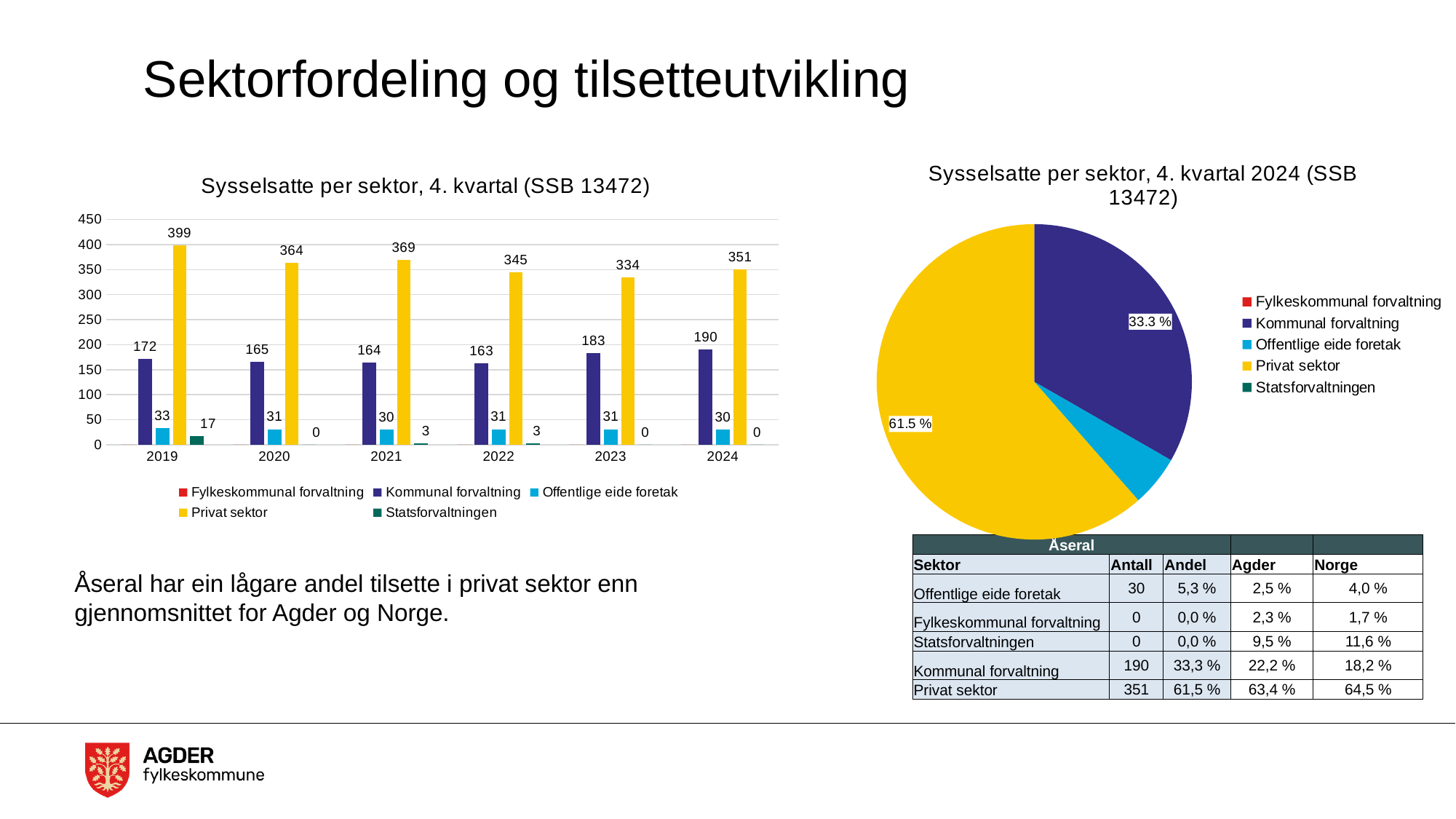
In the bar chart 'Sysselsatte per sektor, 4. kvartal (SSB 13472)', what is the value for Kommunal forvaltning in 2024? 190 In the bar chart 'Sysselsatte per sektor, 4. kvartal (SSB 13472)', how many years are shown on the x axis? 6 In the pie chart 'Sysselsatte per sektor, 4. kvartal 2024 (SSB 13472)', what share does Privat sektor have? 61.5 % In the bar chart 'Sysselsatte per sektor, 4. kvartal (SSB 13472)', what is the value for Privat sektor in 2019? 399 In the pie chart 'Sysselsatte per sektor, 4. kvartal 2024 (SSB 13472)', what share does Kommunal forvaltning have? 33.3 % In the bar chart 'Sysselsatte per sektor, 4. kvartal (SSB 13472)', which year has the highest value for Privat sektor? 2019 In the bar chart 'Sysselsatte per sektor, 4. kvartal (SSB 13472)', what is the value for Statsforvaltningen in 2019? 17 In the bar chart 'Sysselsatte per sektor, 4. kvartal (SSB 13472)', is the Kommunal forvaltning value for 2023 larger than the value for 2022? Yes, 2023 (183) is larger than 2022 (163) In the bar chart 'Sysselsatte per sektor, 4. kvartal (SSB 13472)', what is the difference between the Privat sektor values for 2019 and 2024? 48 In the bar chart 'Sysselsatte per sektor, 4. kvartal (SSB 13472)', which year has the lowest value for Kommunal forvaltning? 2022 In the bar chart 'Sysselsatte per sektor, 4. kvartal (SSB 13472)', how many series does the legend list? 5 What kind of chart is the chart on the left of the slide? Bar chart